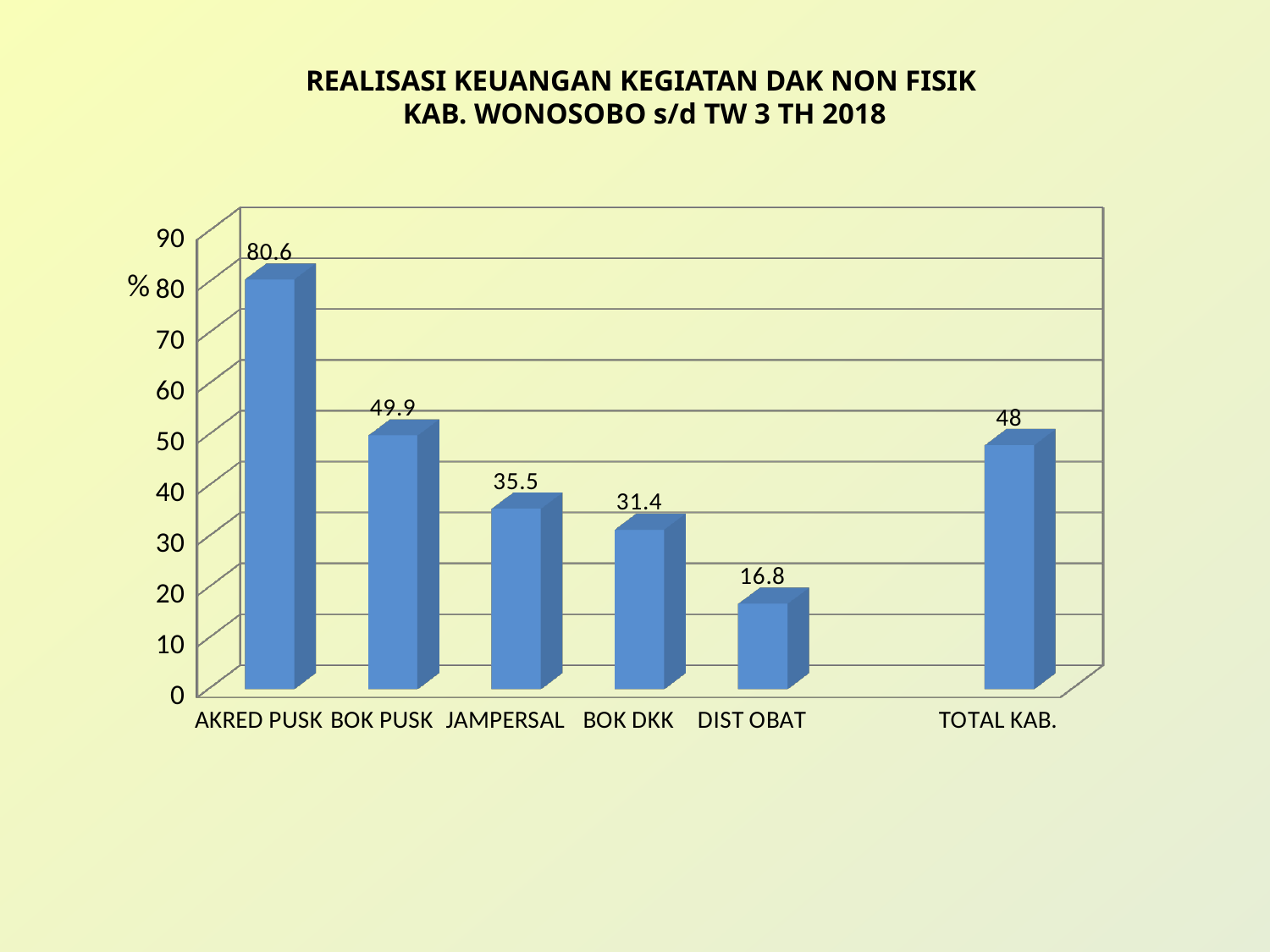
What is the value for BOK PUSK? 49.9 What is the value for DIST OBAT? 16.8 What is the value for JAMPERSAL? 35.5 Which category has the highest value? AKRED PUSK What is the difference between the values for AKRED PUSK and BOK PUSK? 30.7 What kind of chart is shown on the slide? Bar chart What is the title of the chart? REALISASI KEUANGAN KEGIATAN DAK NON FISIK KAB. WONOSOBO s/d TW 3 TH 2018 How many bars are plotted in the chart? 6 Which category has the lowest value? DIST OBAT Which is larger, the value for BOK DKK or the value for JAMPERSAL? JAMPERSAL What is the value for AKRED PUSK? 80.6 What is the value for TOTAL KAB.? 48